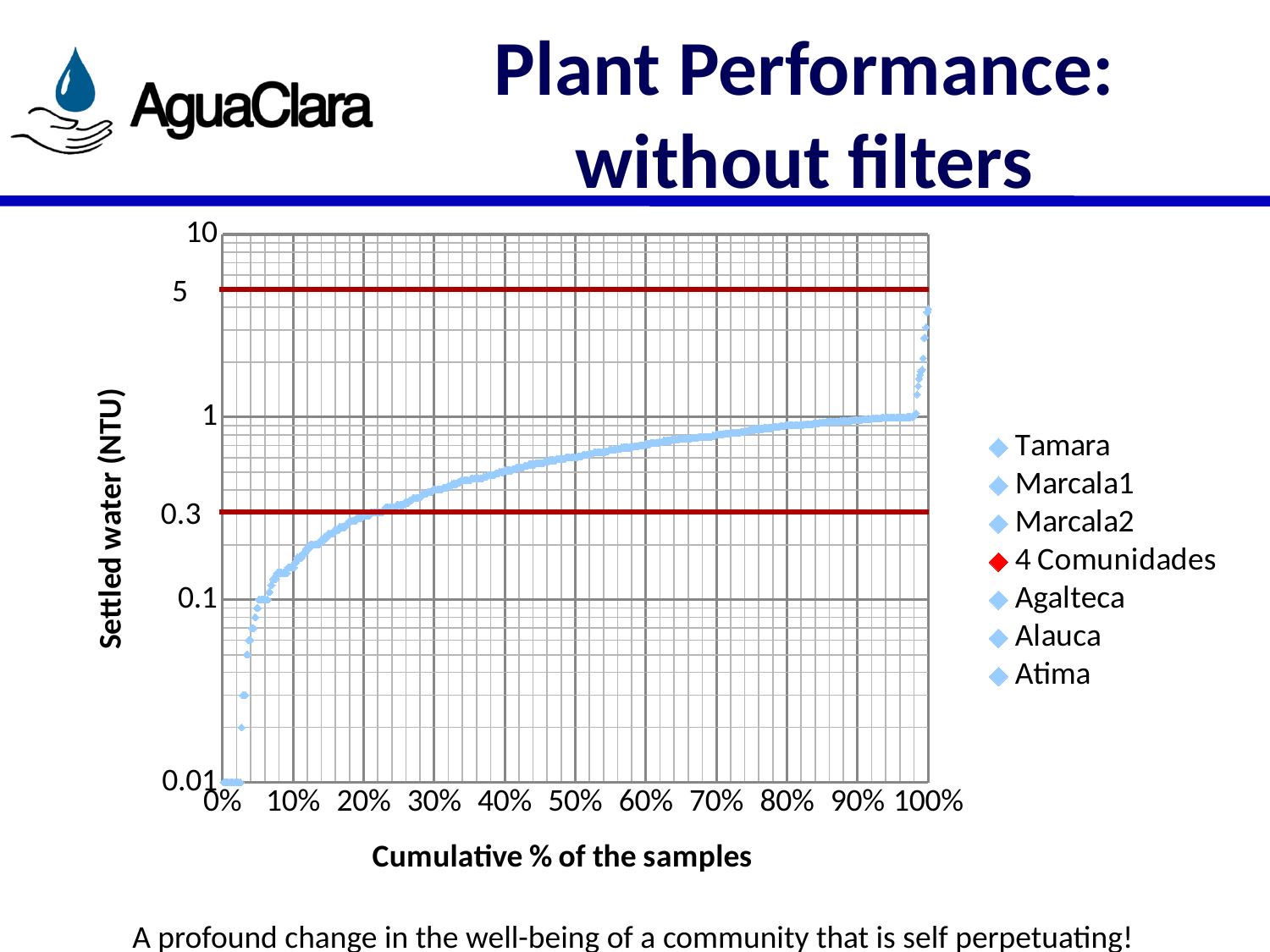
What is the highest value labelled on the y axis? 10 Is the settled water value at 10% cumulative samples greater or less than 0.3 NTU? less Is the settled water value at 40% cumulative samples greater or less than 0.3 NTU? greater Is the settled water value at 70% cumulative samples greater or less than 1 NTU? less How many series does the legend list? 7 Do the plotted settled water values rise or fall as the cumulative % of the samples increases? rise What kind of chart is shown on the slide? scatter chart What is the label of the x axis? Cumulative % of the samples